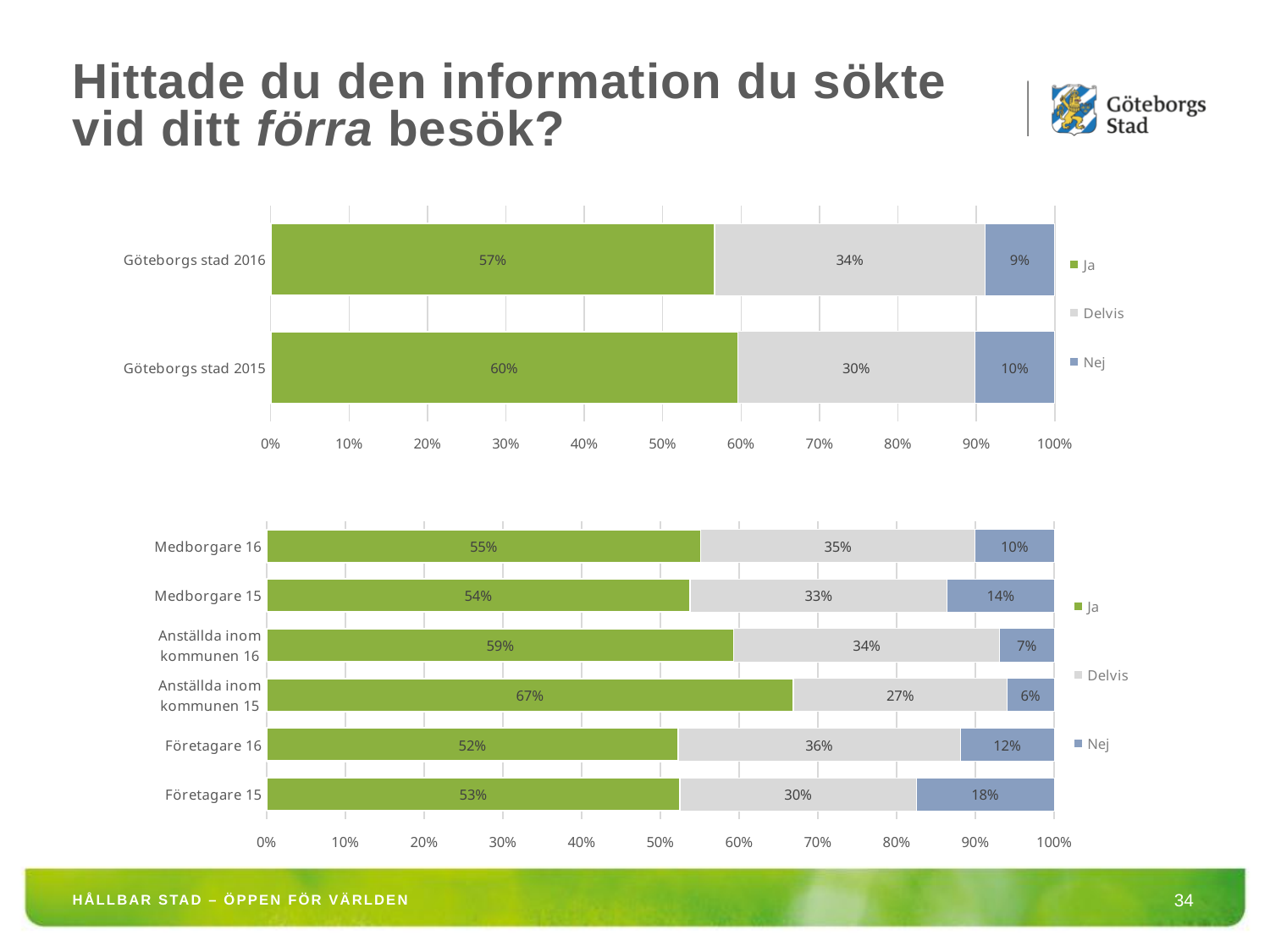
In the top chart, what is the difference between the 'Delvis' values for Göteborgs stad 2016 and Göteborgs stad 2015? 4 percentage points In the bottom chart, which category has the highest 'Ja' value? Anställda inom kommunen 15 In the top chart, what is the 'Nej' value for Göteborgs stad 2015? 10% In the bottom chart, which category has the lowest 'Nej' value? Anställda inom kommunen 15 In the top chart, how many series does the legend list? 3 In the bottom chart, which category has the highest 'Nej' value? Företagare 15 In the bottom chart, what is the difference between the 'Nej' values for Företagare 15 and Företagare 16? 6 percentage points What kind of chart is the bottom chart? Stacked bar chart In the bottom chart, which is larger: the 'Ja' value for Medborgare 16 or the 'Ja' value for Medborgare 15? Medborgare 16 In the bottom chart, what is the 'Delvis' value for Företagare 16? 36% In the top chart, what is the 'Ja' value for Göteborgs stad 2016? 57% In the bottom chart, how many categories are shown? 6